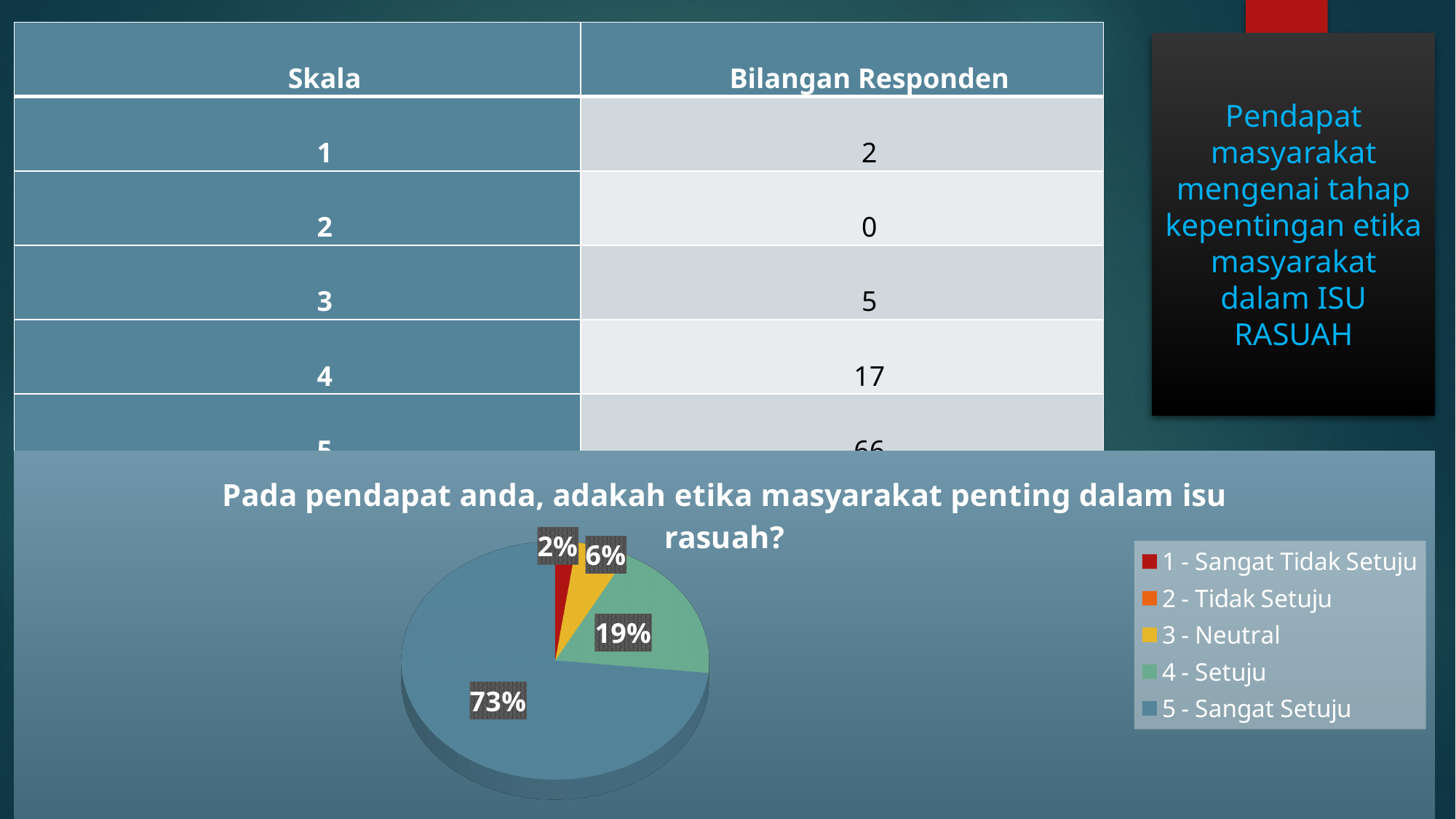
What is the difference in percentage points between the 4 - Setuju slice and the 3 - Neutral slice? 13% Which legend category has the largest slice of the pie chart? 5 - Sangat Setuju Which slice is larger in the pie chart: 4 - Setuju or 3 - Neutral? 4 - Setuju What is the difference in percentage points between the 5 - Sangat Setuju slice and the 4 - Setuju slice? 54% What percentage of the pie chart is labelled for 4 - Setuju? 19% What colour is the 5 - Sangat Setuju slice in the pie chart? Blue What percentage of the pie chart is labelled for 5 - Sangat Setuju? 73% What is the title of the pie chart? Pada pendapat anda, adakah etika masyarakat penting dalam isu rasuah? How many categories does the legend of the pie chart list? 5 What kind of chart is shown on the slide? Pie chart What percentage of the pie chart is labelled for 1 - Sangat Tidak Setuju? 2% What percentage of the pie chart is labelled for 3 - Neutral? 6%